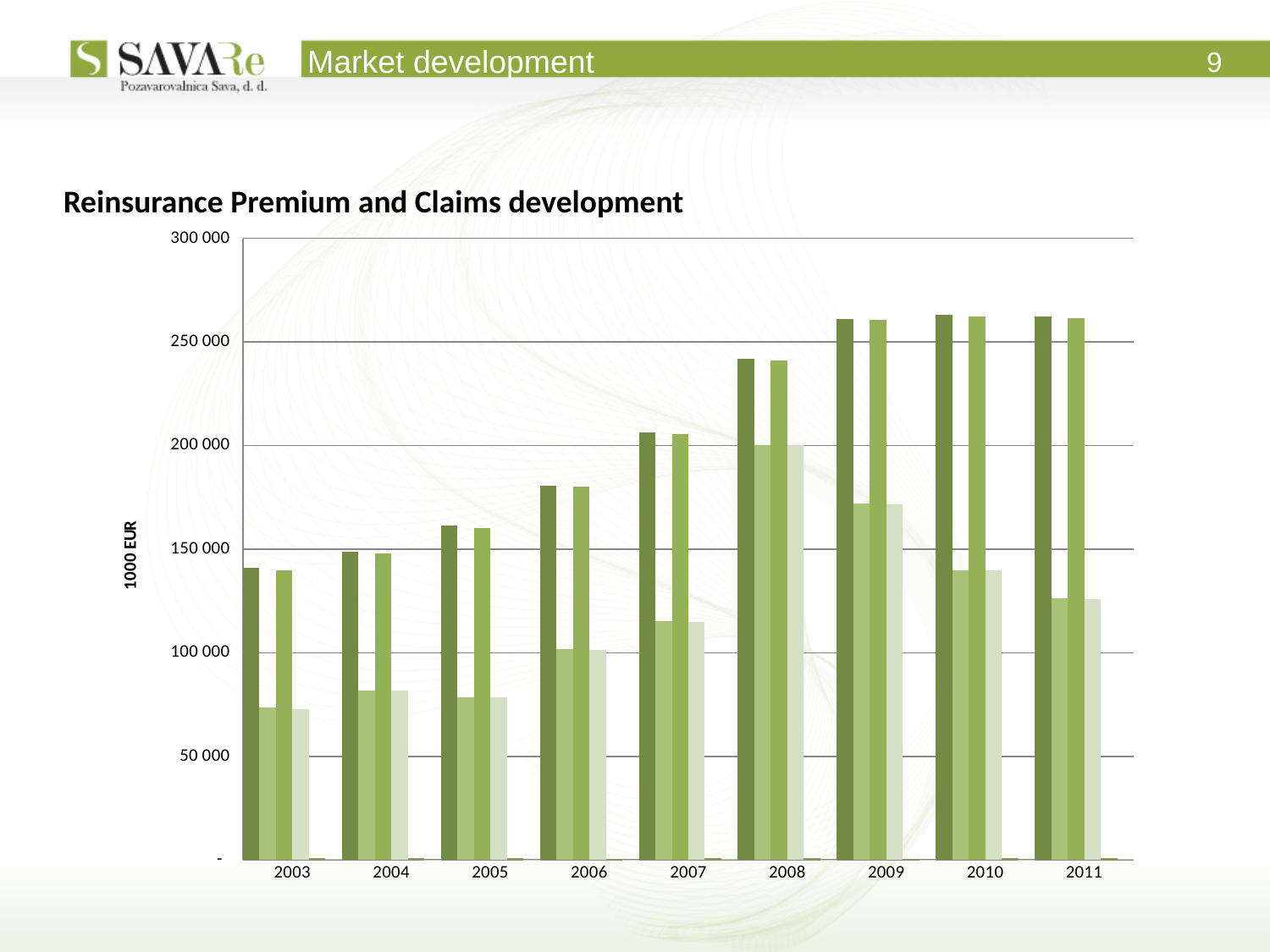
How many years are shown along the x axis of the chart? 9 What is the title of the chart? Reinsurance Premium and Claims development What is the label on the vertical axis of the chart? 1000 EUR Is the tallest bar for 2008 taller or shorter than the tallest bar for 2003? taller What kind of chart is shown on the slide? bar chart Do the tallest bars generally rise or fall from 2003 to 2009? rise Is the value of the tallest bar for 2009 greater or less than 250 000? greater Is the value of the tallest bar for 2008 greater or less than 250 000? less Which year has the shortest tallest bar in the chart? 2003 Is the value of the tallest bar for 2003 greater or less than 150 000? less